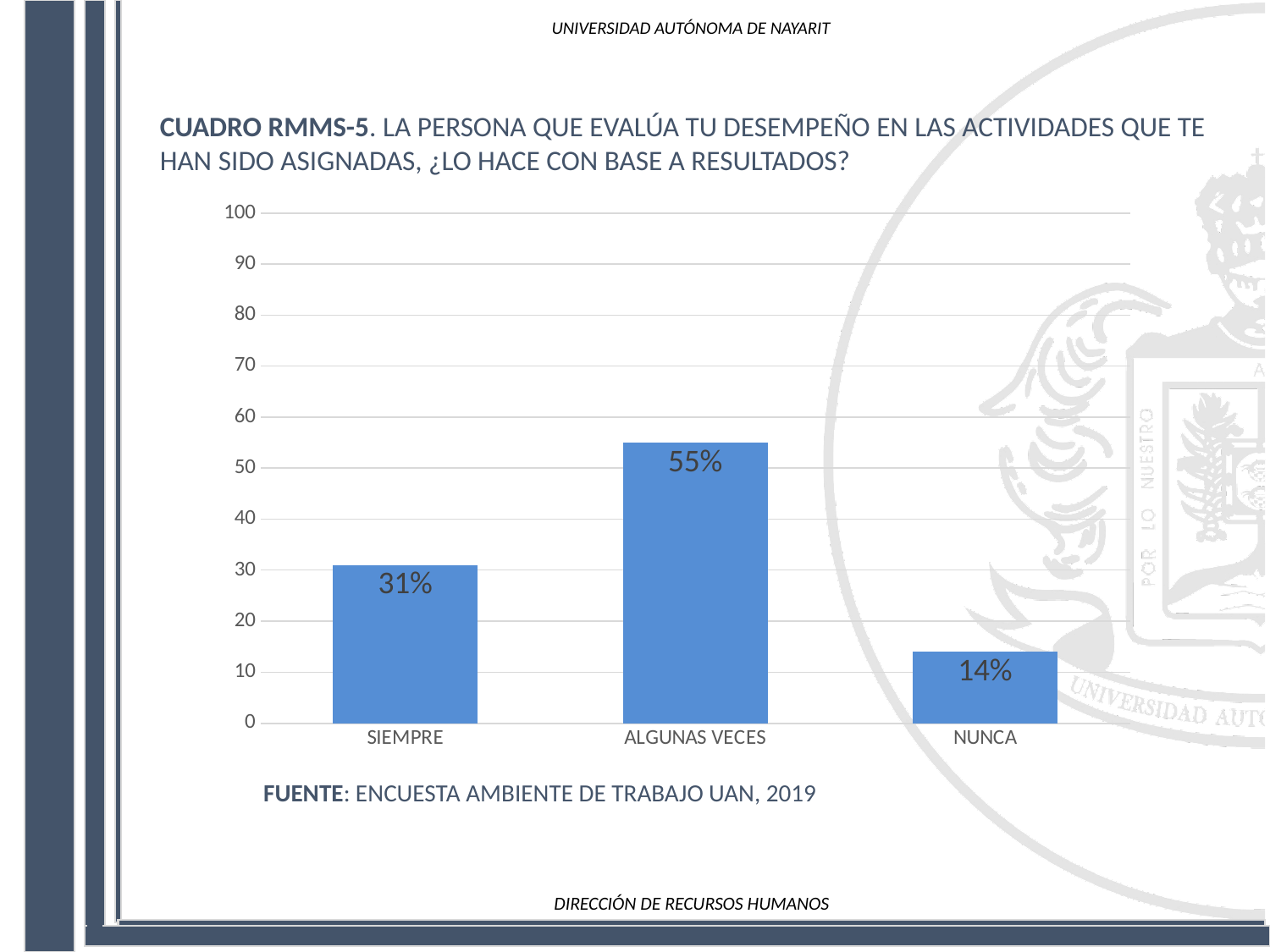
What is the value for NUNCA? 14% What source is cited below the chart? ENCUESTA AMBIENTE DE TRABAJO UAN, 2019 What is the value for SIEMPRE? 31% Which is larger, the value for SIEMPRE or the value for NUNCA? SIEMPRE What is the difference between the values for SIEMPRE and NUNCA? 17% What kind of chart is shown on the slide? bar chart What is the value for ALGUNAS VECES? 55% What is the difference between the values for ALGUNAS VECES and SIEMPRE? 24% Is the value for ALGUNAS VECES greater or less than 50? greater How many categories are shown on the x axis? 3 Which category has the lowest value? NUNCA Which category has the highest value? ALGUNAS VECES